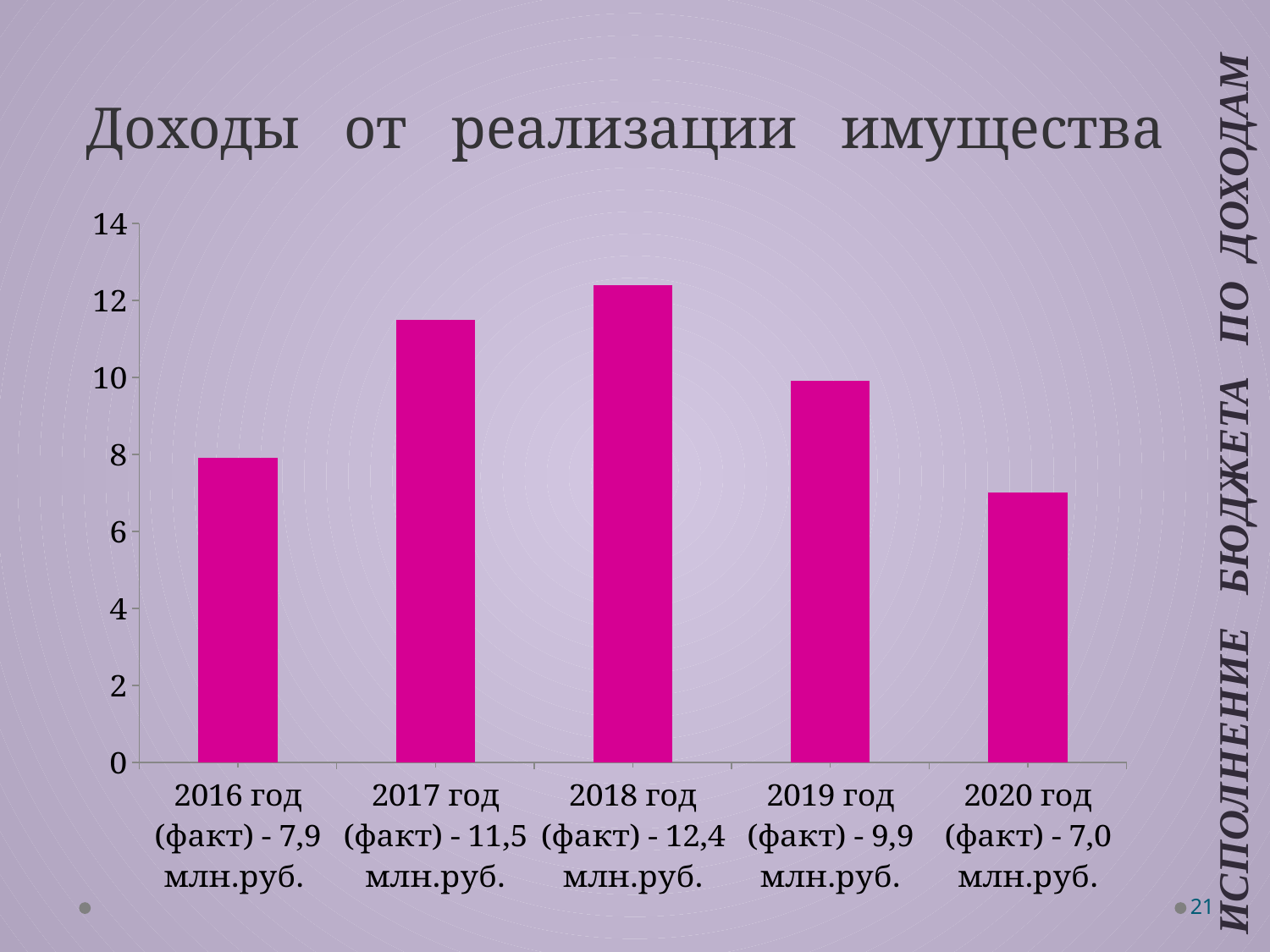
What is the title of the chart? Доходы от реализации имущества Which is larger, the value for 2017 год or the value for 2019 год? 2017 год What is the value for 2018 год (факт)? 12,4 млн.руб. Which year has the lowest value? 2020 год What kind of chart is shown on the slide? bar chart Which year has the highest value? 2018 год What is the value for 2016 год (факт)? 7,9 млн.руб. What is the difference between the values for 2019 год and 2020 год? 2,9 млн.руб. What is the value for 2020 год (факт)? 7,0 млн.руб. Is the value for 2019 год greater or less than 10? less What is the difference between the values for 2018 год and 2017 год? 0,9 млн.руб. How many years are shown on the chart? 5